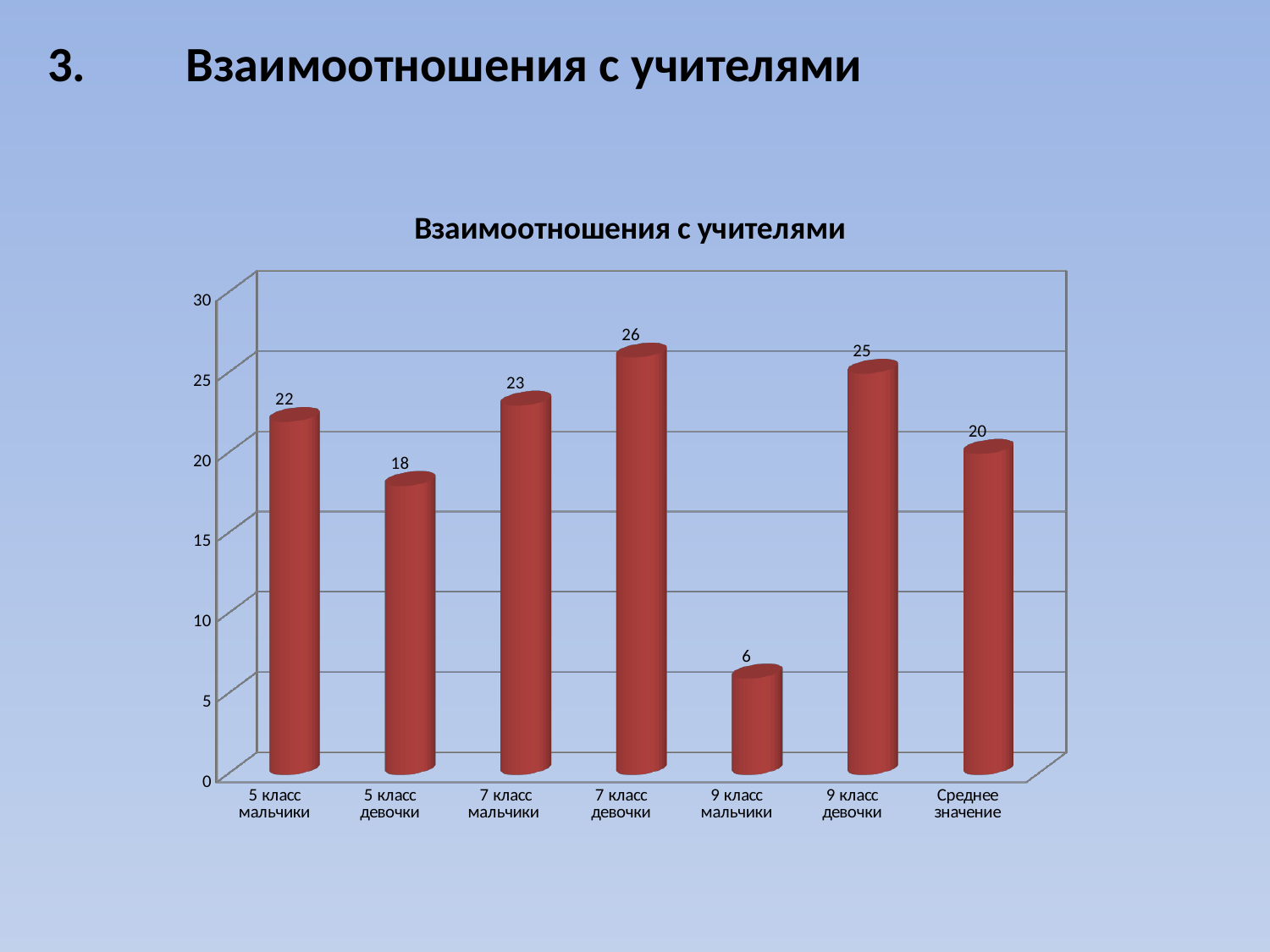
Which category has the lowest value? 9 класс мальчики Which is larger, the value for 5 класс мальчики or 5 класс девочки? 5 класс мальчики How many categories are shown on the x axis? 7 What is the value for Среднее значение? 20 What is the difference between the values for 7 класс девочки and 5 класс девочки? 8 What is the difference between the values for 9 класс девочки and 9 класс мальчики? 19 What is the title of the chart? Взаимоотношения с учителями What is the value for 5 класс мальчики? 22 Which category has the highest value? 7 класс девочки Is the value for 7 класс мальчики greater or less than 20? greater What kind of chart is this? bar chart What is the value for 9 класс мальчики? 6